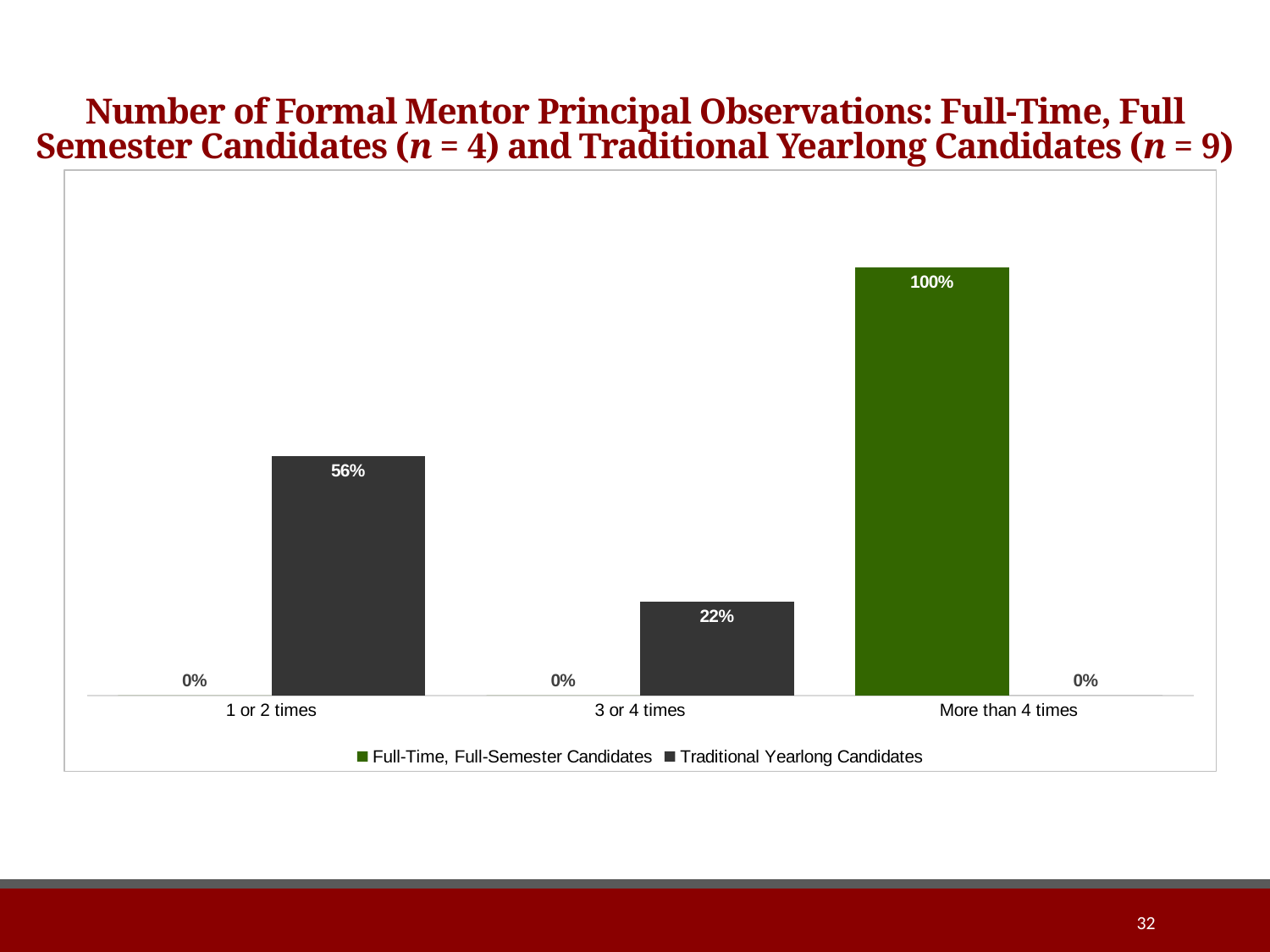
What is the difference between the Traditional Yearlong Candidates values for 1 or 2 times and 3 or 4 times? 34% How many series does the legend list? 2 What kind of chart is shown on the slide? Bar chart For the 3 or 4 times category, which series has the larger value? Traditional Yearlong Candidates What percentage of Full-Time, Full-Semester Candidates had more than 4 formal mentor principal observations? 100% What percentage of Traditional Yearlong Candidates had 1 or 2 formal mentor principal observations? 56% What percentage of Traditional Yearlong Candidates had more than 4 observations? 0% How many categories are shown on the x axis? 3 What percentage of Traditional Yearlong Candidates had 3 or 4 observations? 22% What percentage of Full-Time, Full-Semester Candidates had 1 or 2 observations? 0% Which category has the highest value for Traditional Yearlong Candidates? 1 or 2 times Which colour represents Full-Time, Full-Semester Candidates in the legend? Green